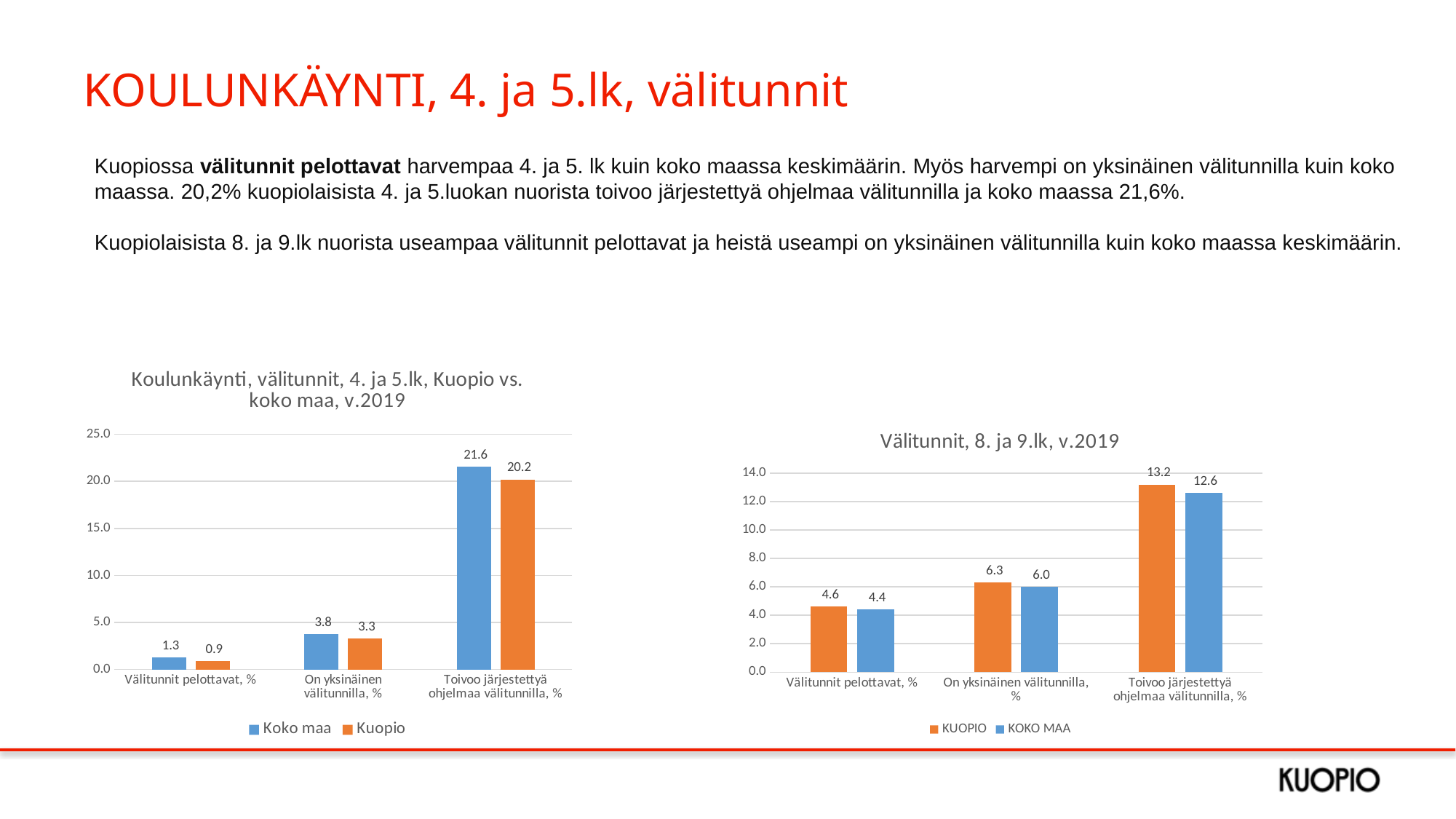
In the chart titled 'Välitunnit, 8. ja 9.lk, v.2019', which is larger for 'On yksinäinen välitunnilla, %': KUOPIO or KOKO MAA? KUOPIO In the chart titled 'Välitunnit, 8. ja 9.lk, v.2019', how many categories are shown on the x axis? 3 In the chart titled 'Koulunkäynti, välitunnit, 4. ja 5.lk, Kuopio vs. koko maa, v.2019', which category has the highest values? Toivoo järjestettyä ohjelmaa välitunnilla, % In the chart titled 'Koulunkäynti, välitunnit, 4. ja 5.lk, Kuopio vs. koko maa, v.2019', which colour represents Kuopio? Orange In the chart titled 'Välitunnit, 8. ja 9.lk, v.2019', what is the KOKO MAA value for 'Toivoo järjestettyä ohjelmaa välitunnilla, %'? 12.6 In the chart titled 'Koulunkäynti, välitunnit, 4. ja 5.lk, Kuopio vs. koko maa, v.2019', how many series does the legend list? 2 What type of chart is the chart titled 'Välitunnit, 8. ja 9.lk, v.2019'? Bar chart In the chart titled 'Koulunkäynti, välitunnit, 4. ja 5.lk, Kuopio vs. koko maa, v.2019', what is the difference between the Koko maa and Kuopio values for 'On yksinäinen välitunnilla, %'? 0.5 In the chart titled 'Koulunkäynti, välitunnit, 4. ja 5.lk, Kuopio vs. koko maa, v.2019', what is the Koko maa value for 'Välitunnit pelottavat, %'? 1.3 In the chart titled 'Välitunnit, 8. ja 9.lk, v.2019', what is the difference between the KUOPIO and KOKO MAA values for 'Toivoo järjestettyä ohjelmaa välitunnilla, %'? 0.6 In the chart titled 'Välitunnit, 8. ja 9.lk, v.2019', what is the KUOPIO value for 'Välitunnit pelottavat, %'? 4.6 In the chart titled 'Koulunkäynti, välitunnit, 4. ja 5.lk, Kuopio vs. koko maa, v.2019', what is the Kuopio value for 'Toivoo järjestettyä ohjelmaa välitunnilla, %'? 20.2